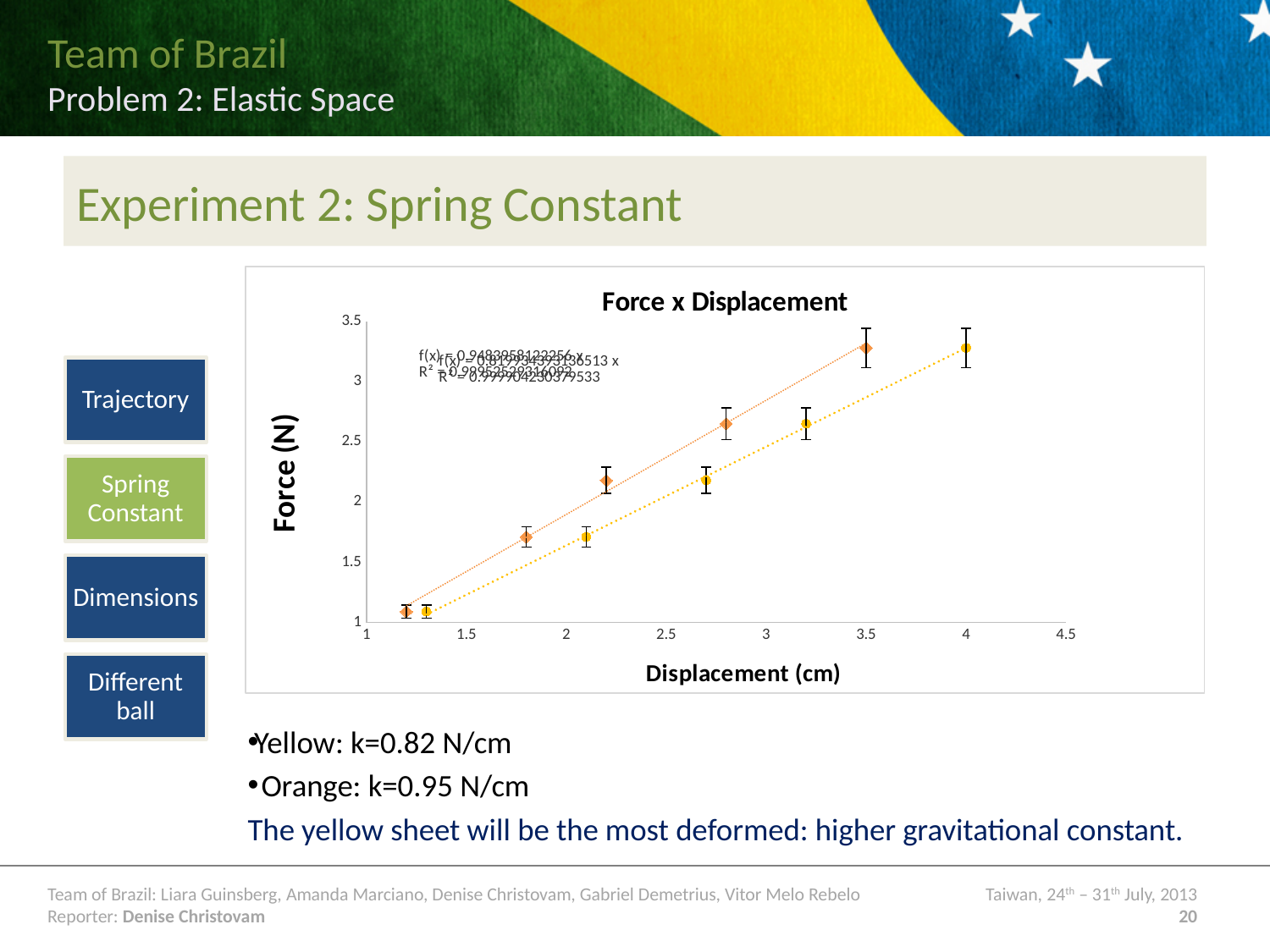
How many data points are plotted for the yellow series? 5 Does the force rise or fall as displacement increases for the orange series? Rise How many data points are plotted for the orange series? 5 Is the force for the orange point at a displacement of 2.8 cm greater or less than 2.5? greater What is the label of the vertical axis of the chart? Force (N) Is the force for the yellow point at a displacement of 2.1 cm greater or less than 2? less At a displacement of about 2.2 cm, which series shows the larger force, orange or yellow? Orange What kind of chart is shown on the slide? Scatter chart Is the force for the orange point at a displacement of 3.5 cm greater or less than 3? greater What is the title of the chart? Force x Displacement How many data points are plotted in total on the chart? 10 Does the force rise or fall as displacement increases for the yellow series? Rise